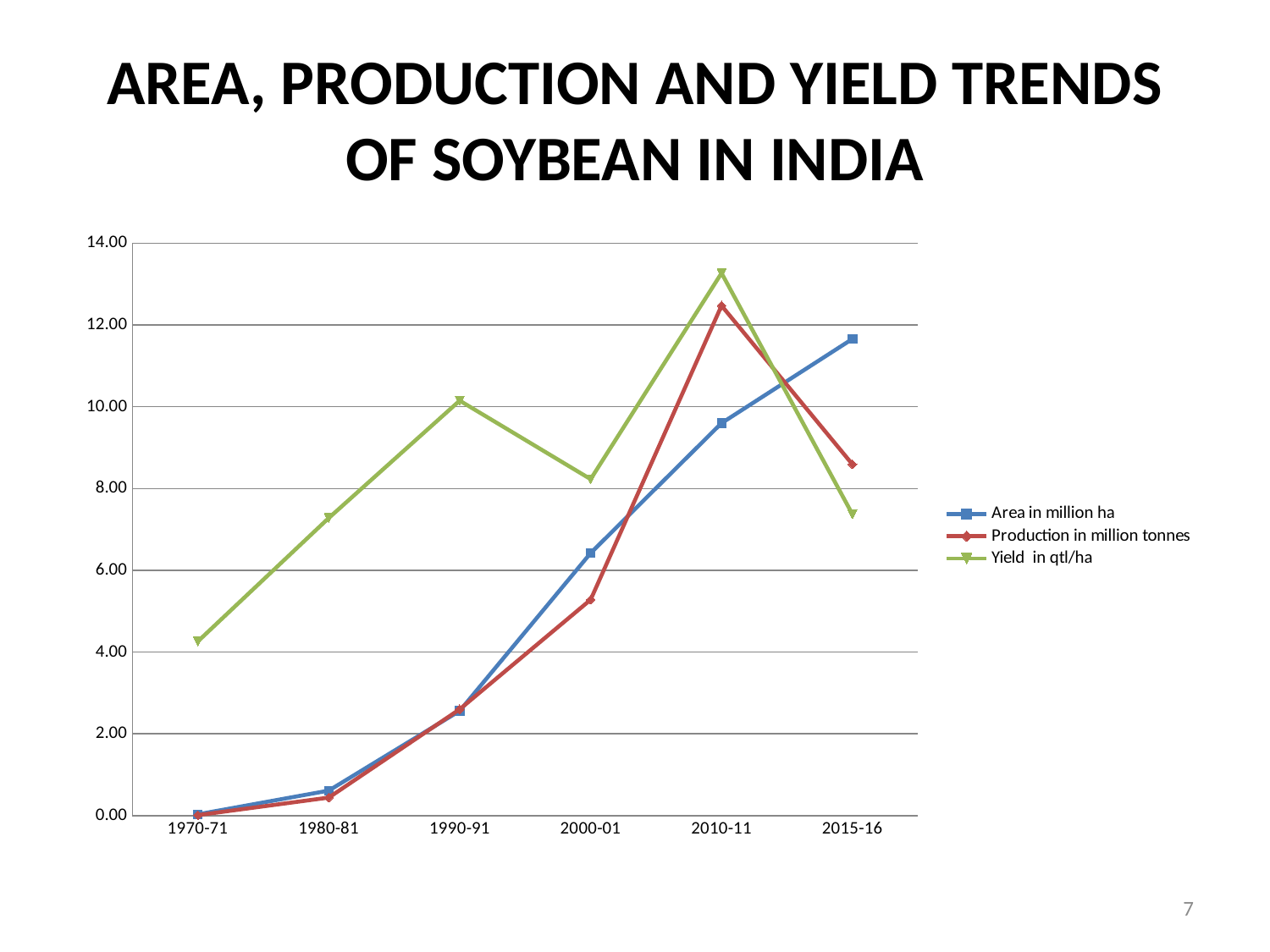
In which period is the Area in million ha highest? 2015-16 In 2015-16, which is larger: Area in million ha or Production in million tonnes? Area in million ha What is the title of the chart on the slide? AREA, PRODUCTION AND YIELD TRENDS OF SOYBEAN IN INDIA What kind of chart is shown on the slide? line chart Is the value for Area in million ha in 2015-16 greater or less than 10.00? greater How many time periods are shown on the x axis? 6 In which period is the Yield in qtl/ha lowest? 1970-71 In 2010-11, which is larger: Production in million tonnes or Area in million ha? Production in million tonnes In which period is the Yield in qtl/ha highest? 2010-11 Does the Area in million ha series rise or fall from 1970-71 to 2015-16? rise How many series does the legend list? 3 Is the value for Production in million tonnes in 2015-16 greater or less than 10.00? less